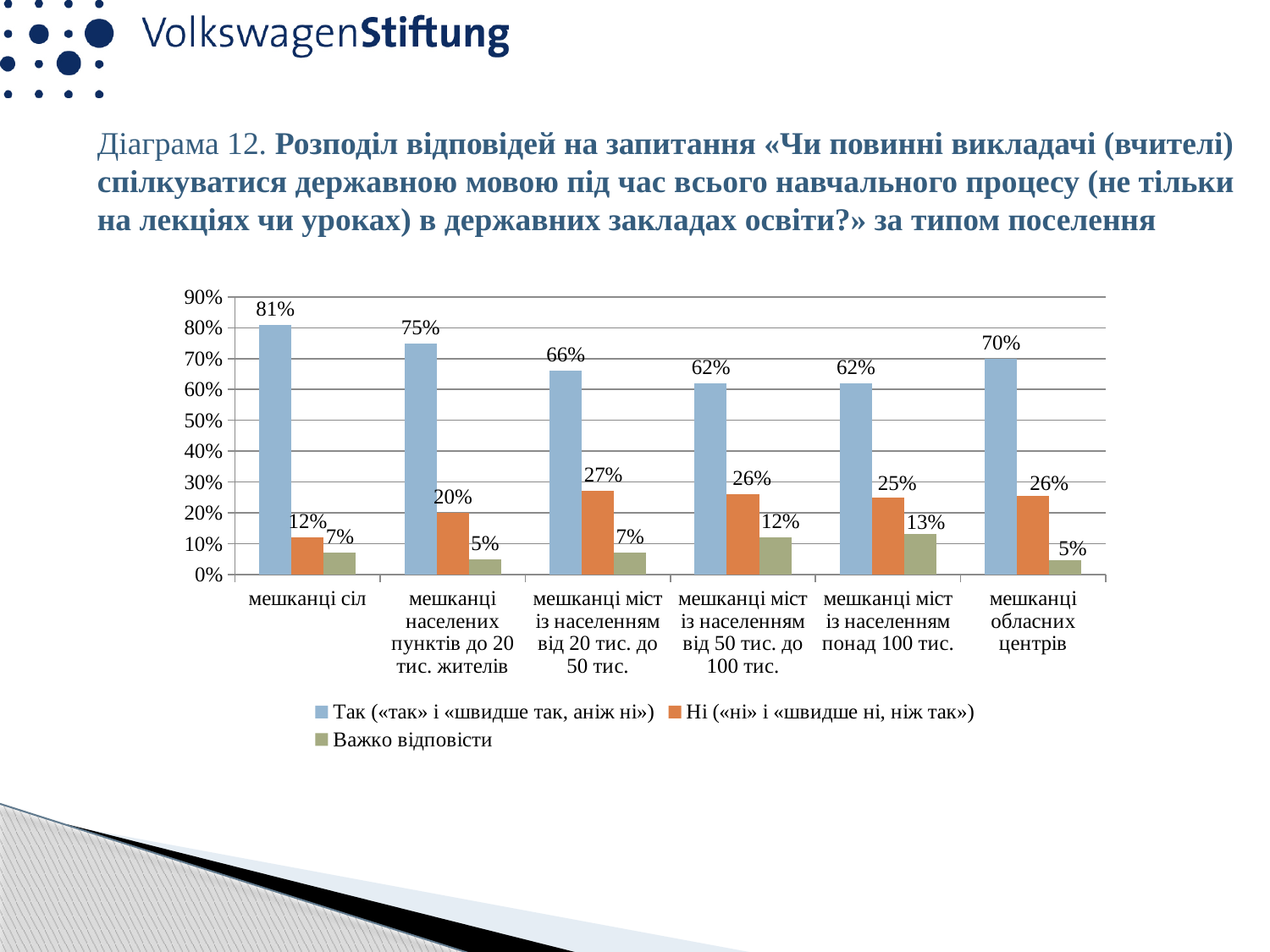
What kind of chart is shown? bar chart What is the value of «Так» for мешканці сіл? 81% What is the value of «Так» for мешканці міст із населенням від 50 тис. до 100 тис.? 62% How many series does the legend list? 3 What colour are the bars for the «Важко відповісти» series? grey-green Which category has the lowest value for «Ні»? мешканці сіл What is the value of «Ні» for мешканці міст із населенням від 20 тис. до 50 тис.? 27% Which is larger: «Ні» for мешканці населених пунктів до 20 тис. жителів or «Ні» for мешканці обласних центрів? мешканці обласних центрів What is the value of «Важко відповісти» for мешканці міст із населенням понад 100 тис.? 13% How many categories are shown on the x axis? 6 What is the difference between the «Так» values for мешканці сіл and мешканці обласних центрів? 11% Which category has the highest value for «Так»? мешканці сіл